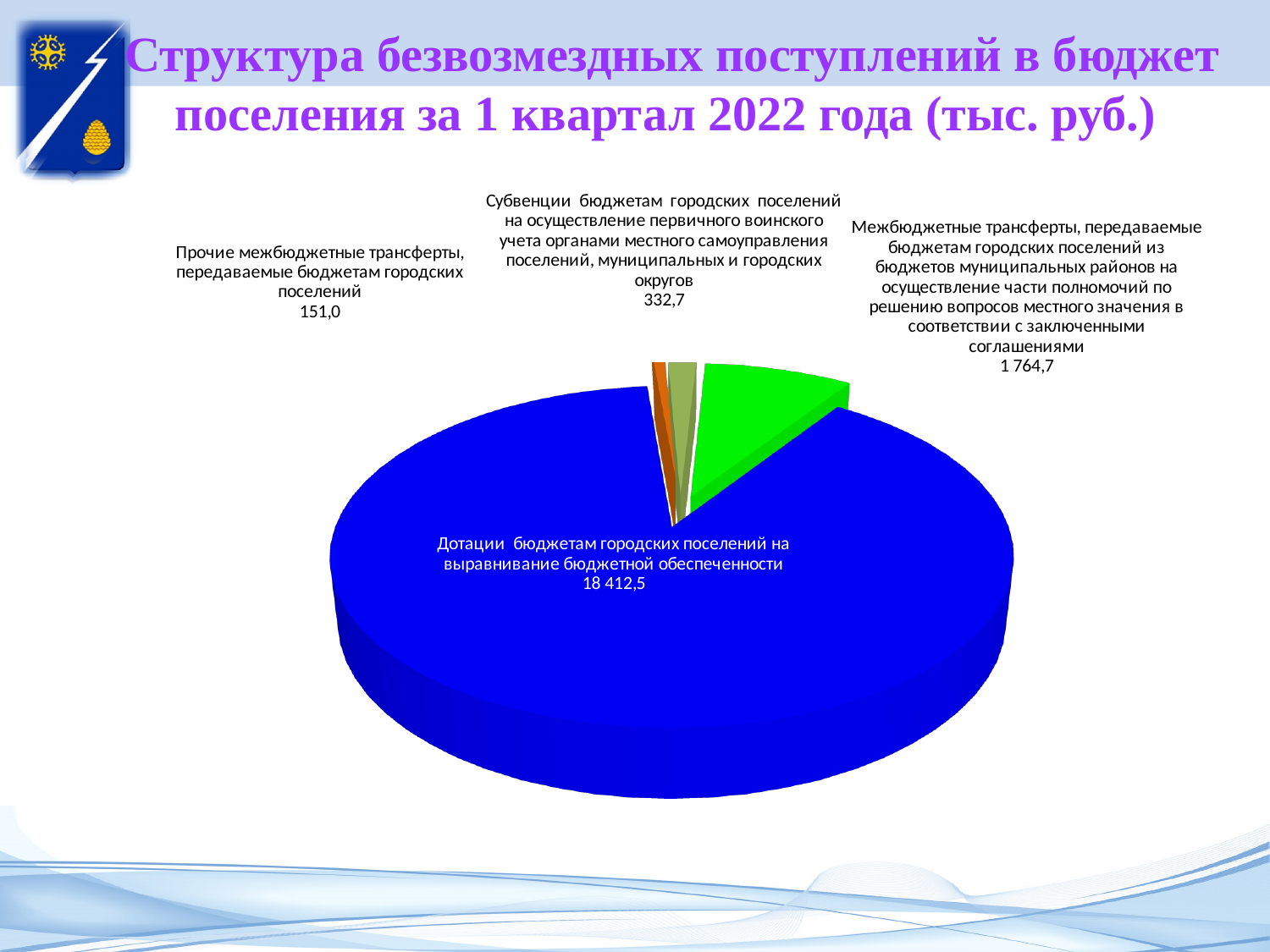
What is the value for «Межбюджетные трансферты, передаваемые бюджетам городских поселений из бюджетов муниципальных районов»? 1 764,7 What colour is the slice for «Дотации бюджетам городских поселений»? Blue What is the difference between «Субвенции» (332,7) and «Прочие межбюджетные трансферты» (151,0)? 181,7 What is the value for «Прочие межбюджетные трансферты, передаваемые бюджетам городских поселений»? 151,0 Which category has the largest value in the pie chart? Дотации бюджетам городских поселений на выравнивание бюджетной обеспеченности What is the value for «Субвенции бюджетам городских поселений на осуществление первичного воинского учета»? 332,7 Which category has the smallest value in the pie chart? Прочие межбюджетные трансферты, передаваемые бюджетам городских поселений What is the value for «Дотации бюджетам городских поселений на выравнивание бюджетной обеспеченности»? 18 412,5 Which is larger: «Субвенции» or «Прочие межбюджетные трансферты»? Субвенции What is the difference between «Дотации» (18 412,5) and «Межбюджетные трансферты» (1 764,7)? 16 647,8 What type of chart is shown on the slide? Pie chart How many slices does the pie chart have? 4